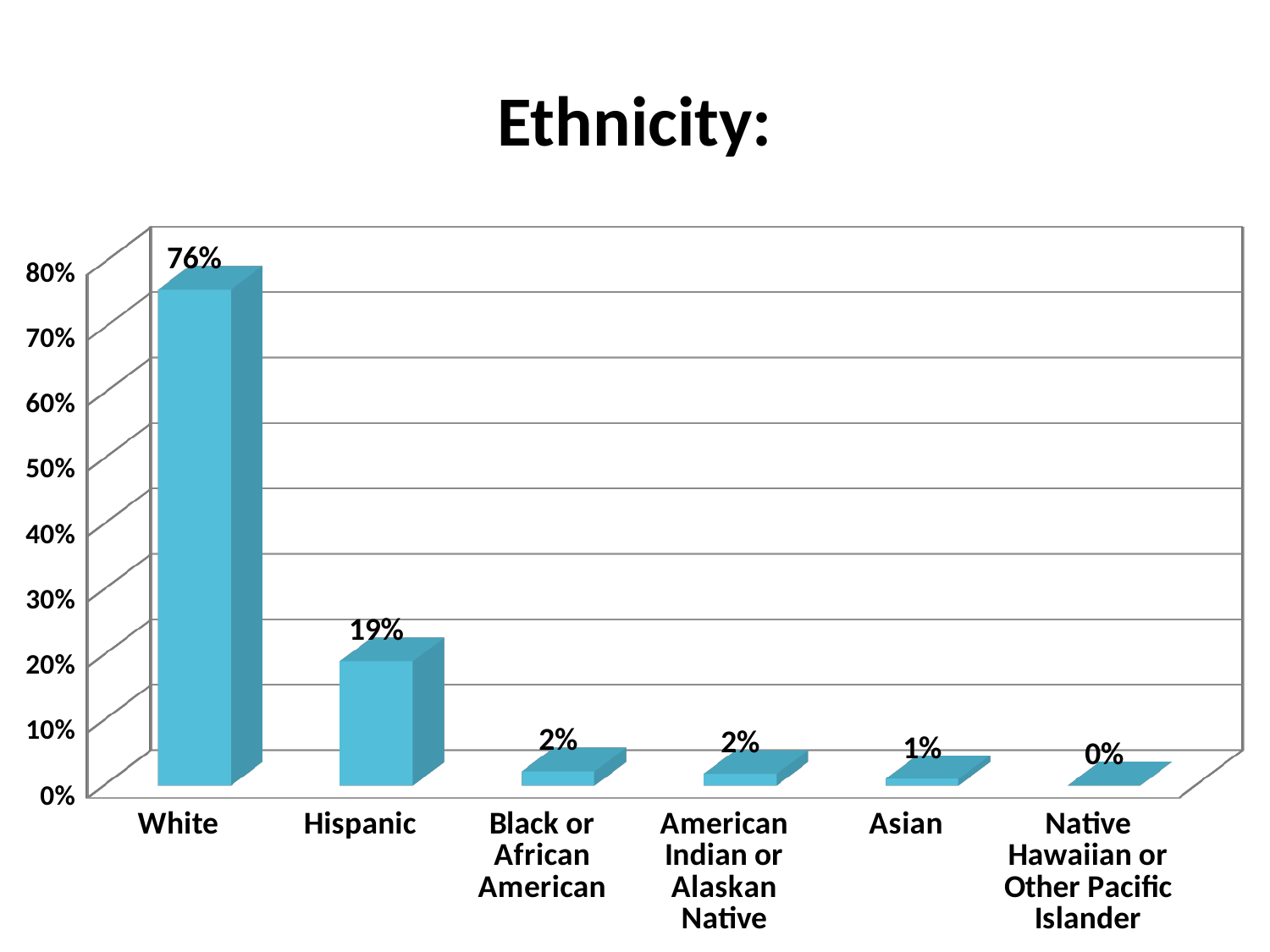
What is the value for Native Hawaiian or Other Pacific Islander? 0% Which category has the highest value? White What is the value for White? 76% Is the value for White greater or less than 70%? greater What is the value for Asian? 1% What is the title of the chart? Ethnicity: Which is larger, the value for Hispanic or the value for Black or African American? Hispanic Which category has the lowest value? Native Hawaiian or Other Pacific Islander What is the difference between the values for White and Hispanic? 57% How many categories are shown on the chart? 6 What kind of chart is shown on the slide? Bar chart What is the value for Hispanic? 19%